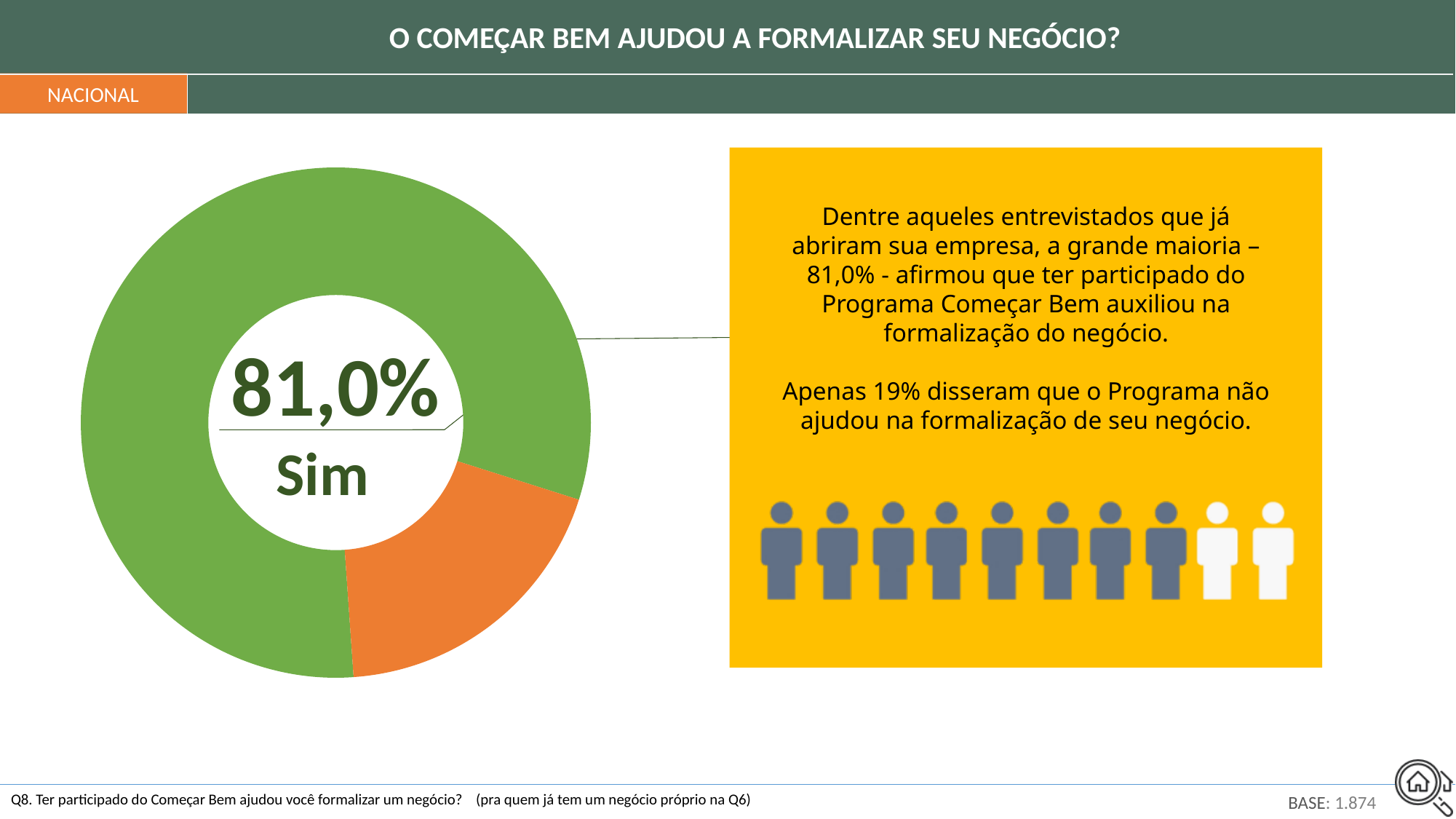
Which slice is larger, the green one or the orange one? the green one (Sim) According to the slide, what percentage said the Programme did not help formalize their business? 19% What is the title of the slide containing the chart? O COMEÇAR BEM AJUDOU A FORMALIZAR SEU NEGÓCIO? What kind of chart is shown on the slide? donut (pie) chart What percentage of respondents answered "Sim" according to the chart? 81,0% How many slices does the donut chart have? 2 What share of the donut chart does the "Sim" slice represent? 81,0% What label is shown in the centre of the donut chart below the percentage? Sim What colour is the "Sim" slice of the donut chart? green Which slice of the donut chart is the largest? Sim